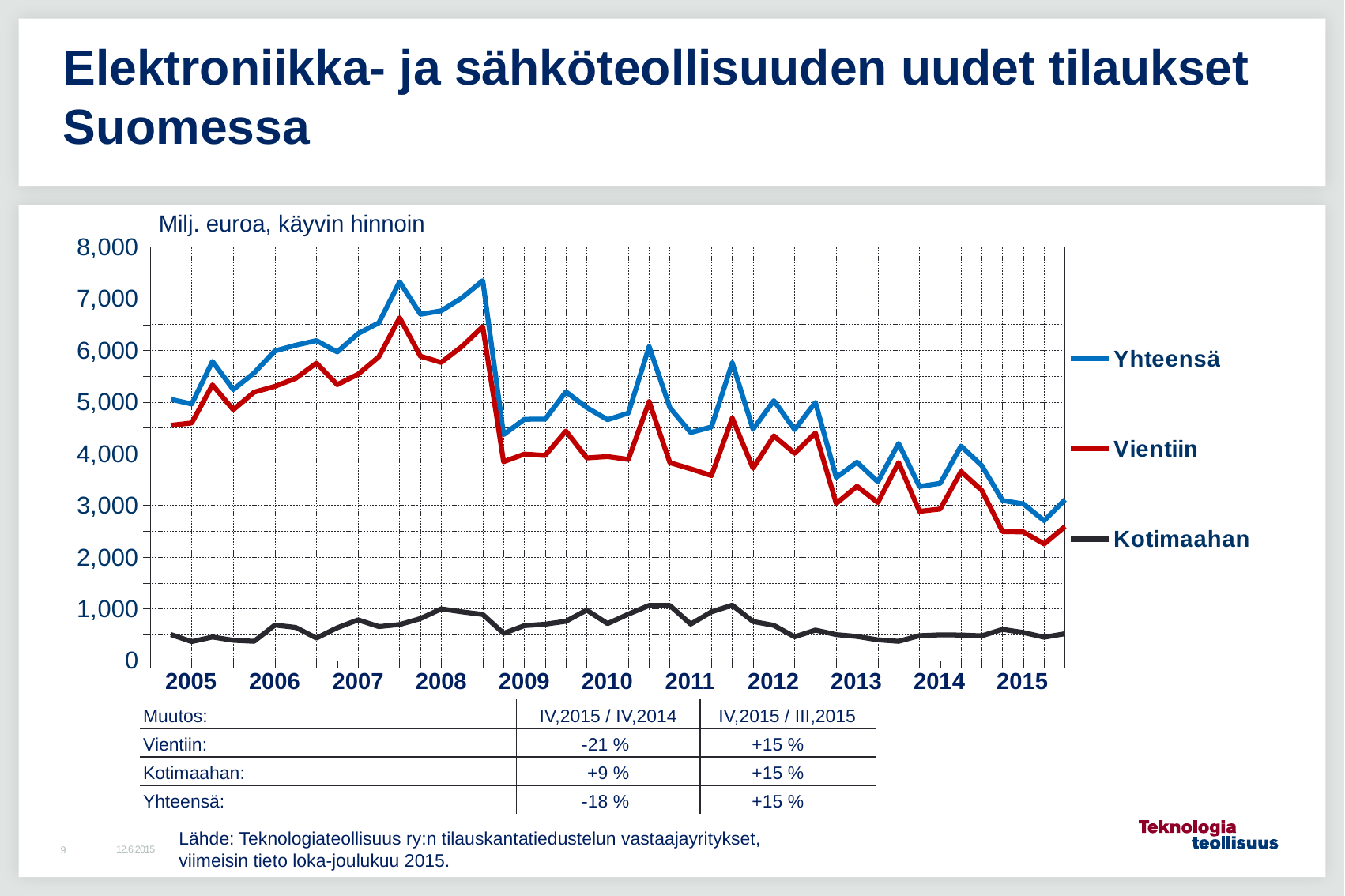
Do the Yhteensä values rise or fall from 2008 to 2015? fall Which series has larger values, Vientiin or Kotimaahan? Vientiin What unit label is shown above the chart's y axis? Milj. euroa, käyvin hinnoin What colour is the Vientiin line in the chart? red How many series does the chart legend list? 3 What kind of chart is shown on the slide? line chart Is the value for Vientiin at the end of 2015 greater or less than 3,000? less How many year labels are shown on the x axis? 11 Which series is plotted with the lowest values throughout the chart? Kotimaahan Which series is plotted with the highest values throughout the chart? Yhteensä Is the value for Kotimaahan ever greater or less than 2,000 across the chart? less Is the peak value of Yhteensä in 2008 greater or less than 7,000? greater